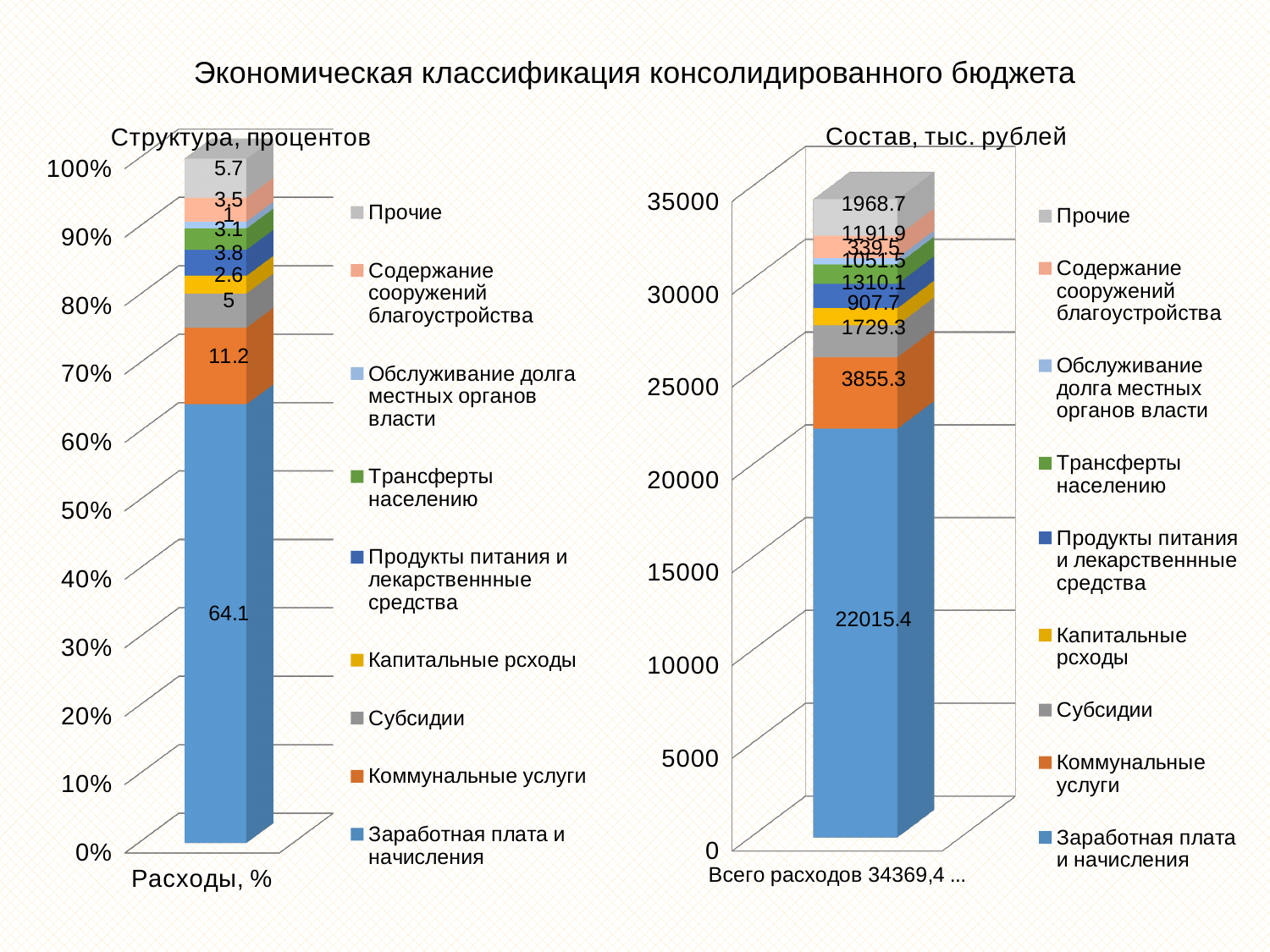
In the chart titled "Состав, тыс. рублей", what is the difference between Коммунальные услуги and Субсидии? 2126.0 In the chart titled "Состав, тыс. рублей", what is the value for Прочие? 1968.7 In the chart titled "Структура, процентов", what is the value for Заработная плата и начисления? 64.1 In the chart titled "Состав, тыс. рублей", what is the total of the stacked bar as stated on the slide? 34369,4 In the chart titled "Состав, тыс. рублей", what is the value for Субсидии? 1729.3 In the chart titled "Состав, тыс. рублей", what is the value for Заработная плата и начисления? 22015.4 What kind of chart is the chart titled "Состав, тыс. рублей"? Stacked bar chart In the chart titled "Структура, процентов", which is larger: Продукты питания и лекарственнные средства or Трансферты населению? Продукты питания и лекарственнные средства In the chart titled "Структура, процентов", which series has the largest share? Заработная плата и начисления How many series does the legend of the chart titled "Состав, тыс. рублей" list? 9 In the chart titled "Структура, процентов", which series has the smallest share? Обслуживание долга местных органов власти In the chart titled "Структура, процентов", what is the value for Коммунальные услуги? 11.2